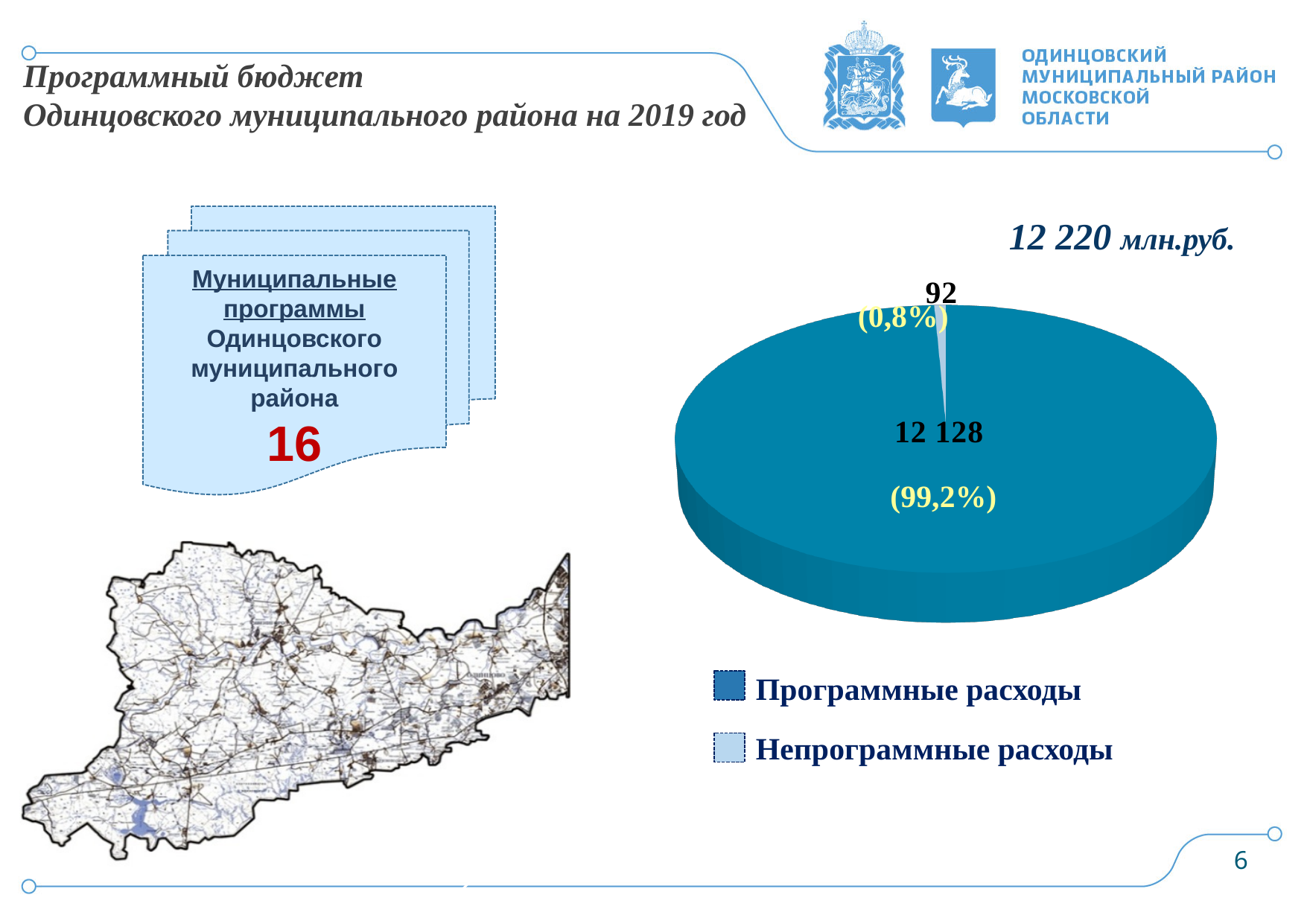
How many entries does the legend of the pie chart list? 2 Which slice of the pie chart is the smallest? Непрограммные расходы What is the difference between the values for Программные расходы and Непрограммные расходы? 12 036 What share of the pie does Непрограммные расходы take? 0,8% How many slices does the pie chart have? 2 What share of the pie does Программные расходы take? 99,2% What is the value for Программные расходы in the pie chart? 12 128 What is the value for Непрограммные расходы in the pie chart? 92 What is the total of the two slices in the pie chart? 12 220 Which slice of the pie chart is the largest? Программные расходы What kind of chart is shown on the slide? pie chart Which is larger, Программные расходы or Непрограммные расходы? Программные расходы